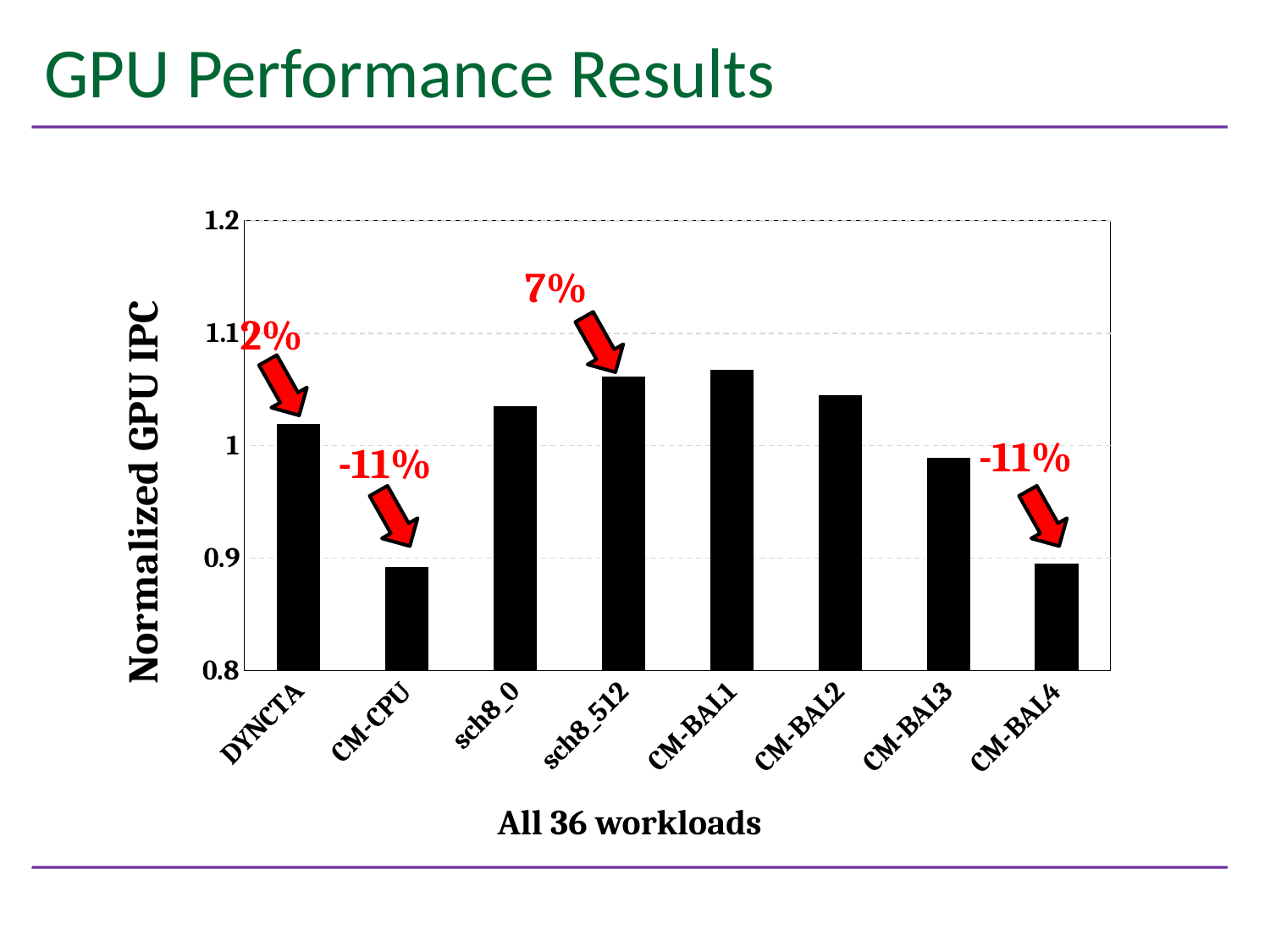
What is the title of the y-axis? Normalized GPU IPC What kind of chart is shown on the slide? bar chart What percentage annotation is shown above the sch8_512 bar? 7% Which has the larger value, sch8_0 or CM-BAL3? sch8_0 Which has the larger value, CM-BAL2 or CM-BAL4? CM-BAL2 Is the value for CM-CPU greater or less than 0.9? less Is the value for CM-BAL1 greater or less than 1.1? less How many categories (bars) are plotted in the chart? 8 Is the value for DYNCTA greater or less than 1? greater Which has the larger value, DYNCTA or CM-CPU? DYNCTA